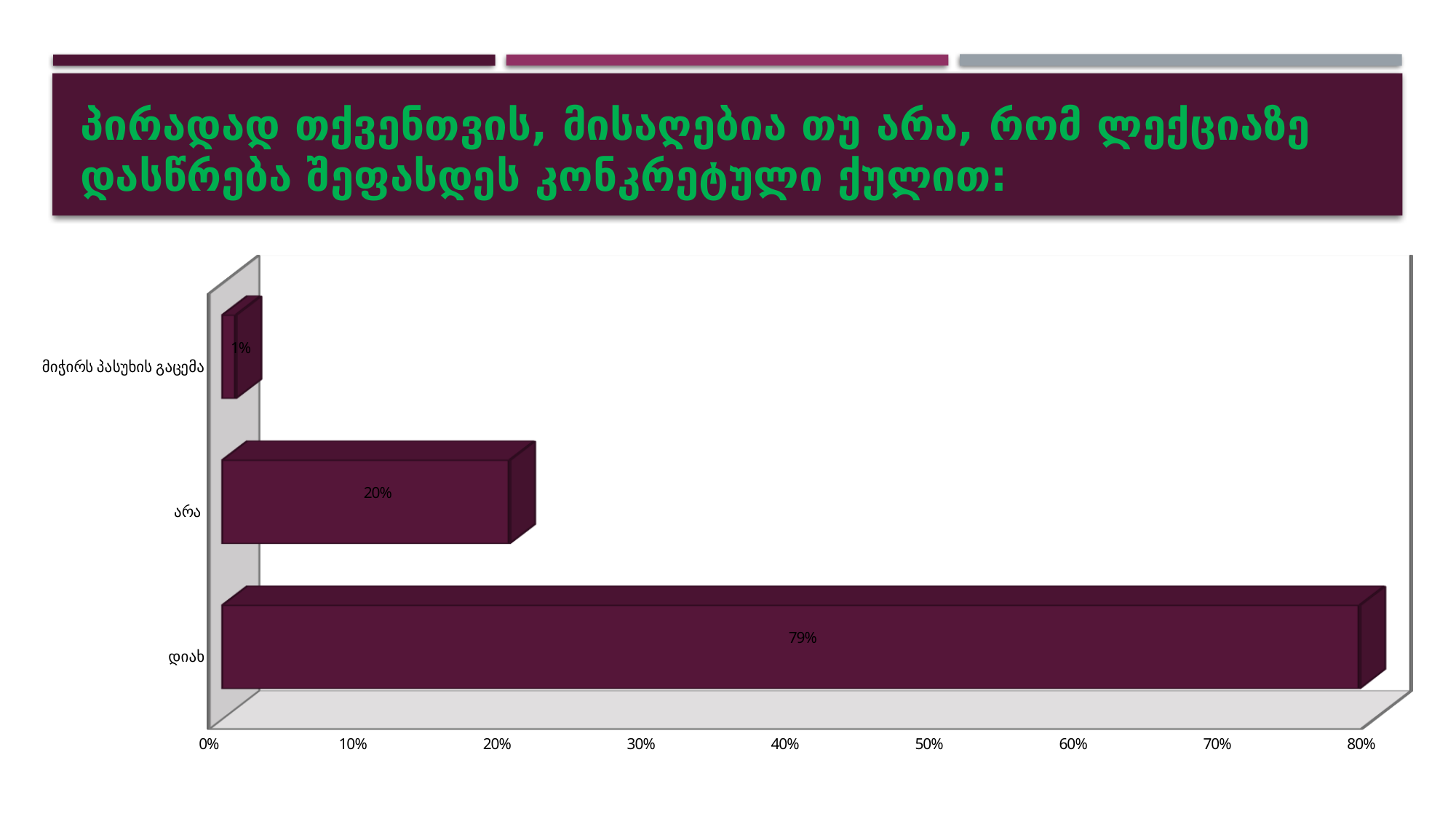
Which category has the lowest value? მიჭირს პასუხის გაცემა What is the value for დიახ? 79% What kind of chart is shown on the slide? bar chart What is the highest value shown on the horizontal axis? 80% Which category has the highest value? დიახ What is the difference between the values for არა and მიჭირს პასუხის გაცემა? 19% What is the value for მიჭირს პასუხის გაცემა? 1% How many categories are shown in the chart? 3 What is the difference between the values for დიახ and არა? 59% Which is larger, the value for არა or the value for მიჭირს პასუხის გაცემა? არა Is the value for დიახ greater or less than 70%? greater What is the value for არა? 20%